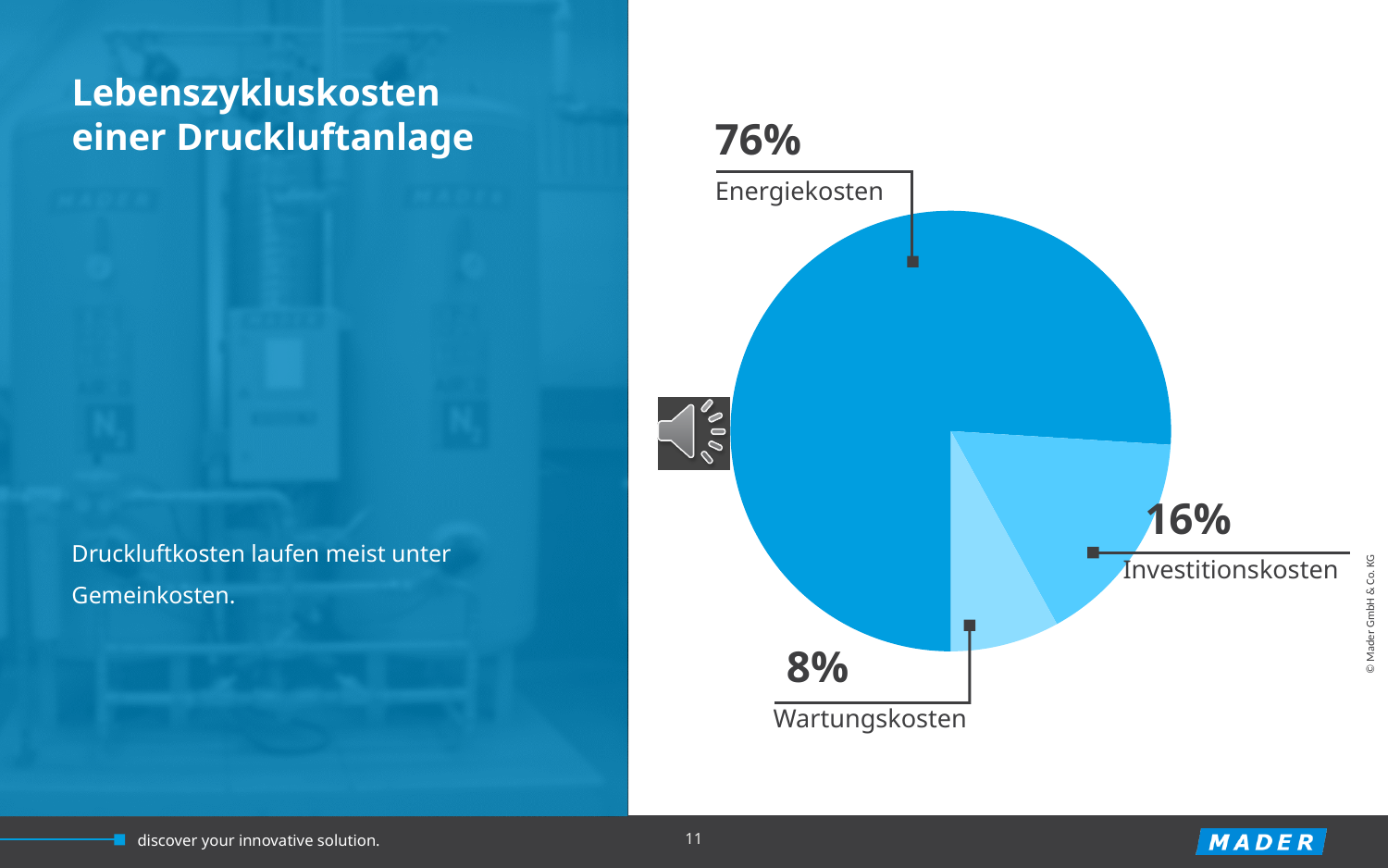
Which category has the largest slice of the pie chart? Energiekosten What is the difference in percentage points between Energiekosten and Investitionskosten? 60 What share of the pie chart is Wartungskosten? 8% What share of the pie chart is Investitionskosten? 16% What is the title of the slide containing the pie chart? Lebenszykluskosten einer Druckluftanlage What is the difference in percentage points between Investitionskosten and Wartungskosten? 8 What share of the pie chart is Energiekosten? 76% Which category has the smallest slice of the pie chart? Wartungskosten What kind of chart is shown on the slide? Pie chart How many categories does the pie chart show? 3 What is the combined share of Investitionskosten and Wartungskosten? 24% Which is larger, Investitionskosten or Wartungskosten? Investitionskosten